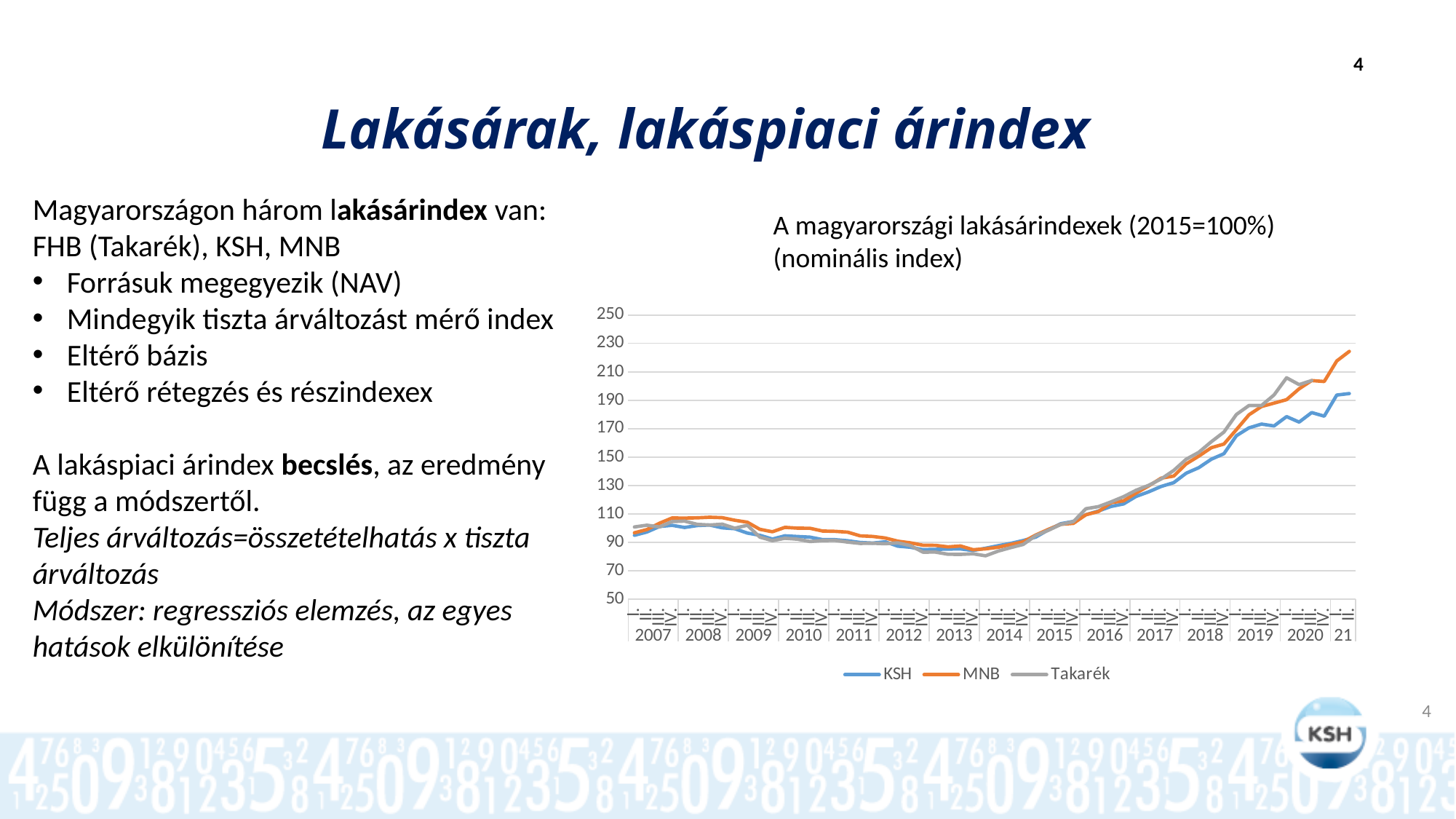
Do the index values rise or fall along the x axis from 2008 to 2013? fall At the end of 2021, is the MNB value greater or less than 210? greater Which series has the highest value at the end of the chart in 2021? MNB How many series does the chart legend list? 3 Which series has the lowest value at the end of the chart in 2021? KSH What are the three series named in the chart legend? KSH, MNB, Takarék How many years are labelled on the x axis of the chart? 15 What kind of chart is shown on the slide? line chart At the end of 2021, which is larger, the MNB value or the KSH value? MNB Do the index values rise or fall along the x axis from 2014 to 2021? rise In 2013, is the KSH value greater or less than 90? less What is the title of the chart? A magyarországi lakásárindexek (2015=100%) (nominális index)